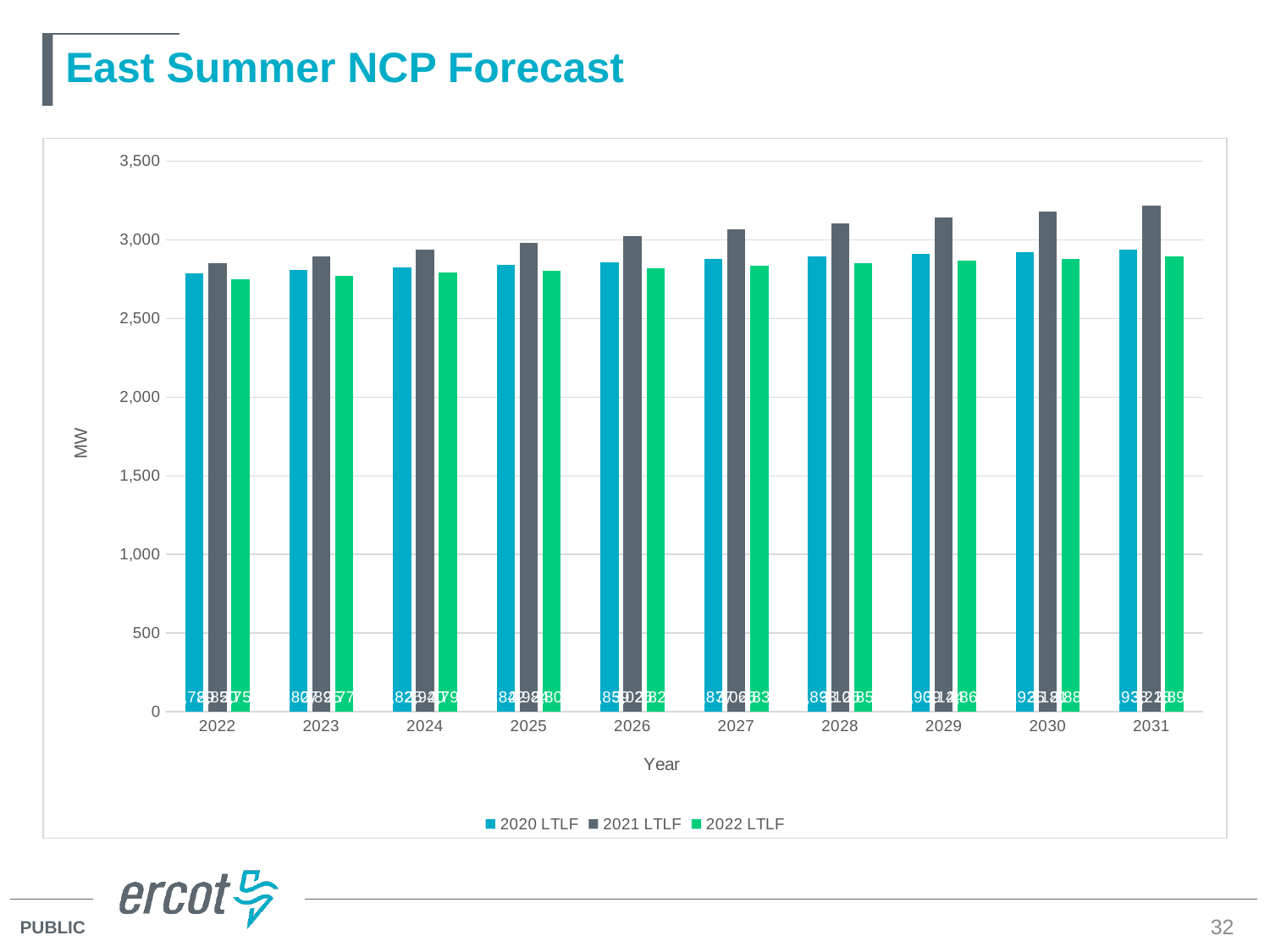
How many series does the legend list? 3 How many years are shown on the x axis? 10 What kind of chart is shown on the slide? bar chart Is the 2021 LTLF value for 2024 greater or less than 3,000? less Is the 2022 LTLF value for 2031 greater or less than 3,000? less What is the label on the y axis? MW Is the 2021 LTLF value for 2031 greater or less than 3,000? greater Which series has the highest value in 2031? 2021 LTLF Do the 2021 LTLF values rise or fall from 2022 to 2031? rise Which year has the highest 2021 LTLF value? 2031 In 2022, which is larger: the 2020 LTLF value or the 2021 LTLF value? 2021 LTLF Which year has the lowest 2020 LTLF value? 2022